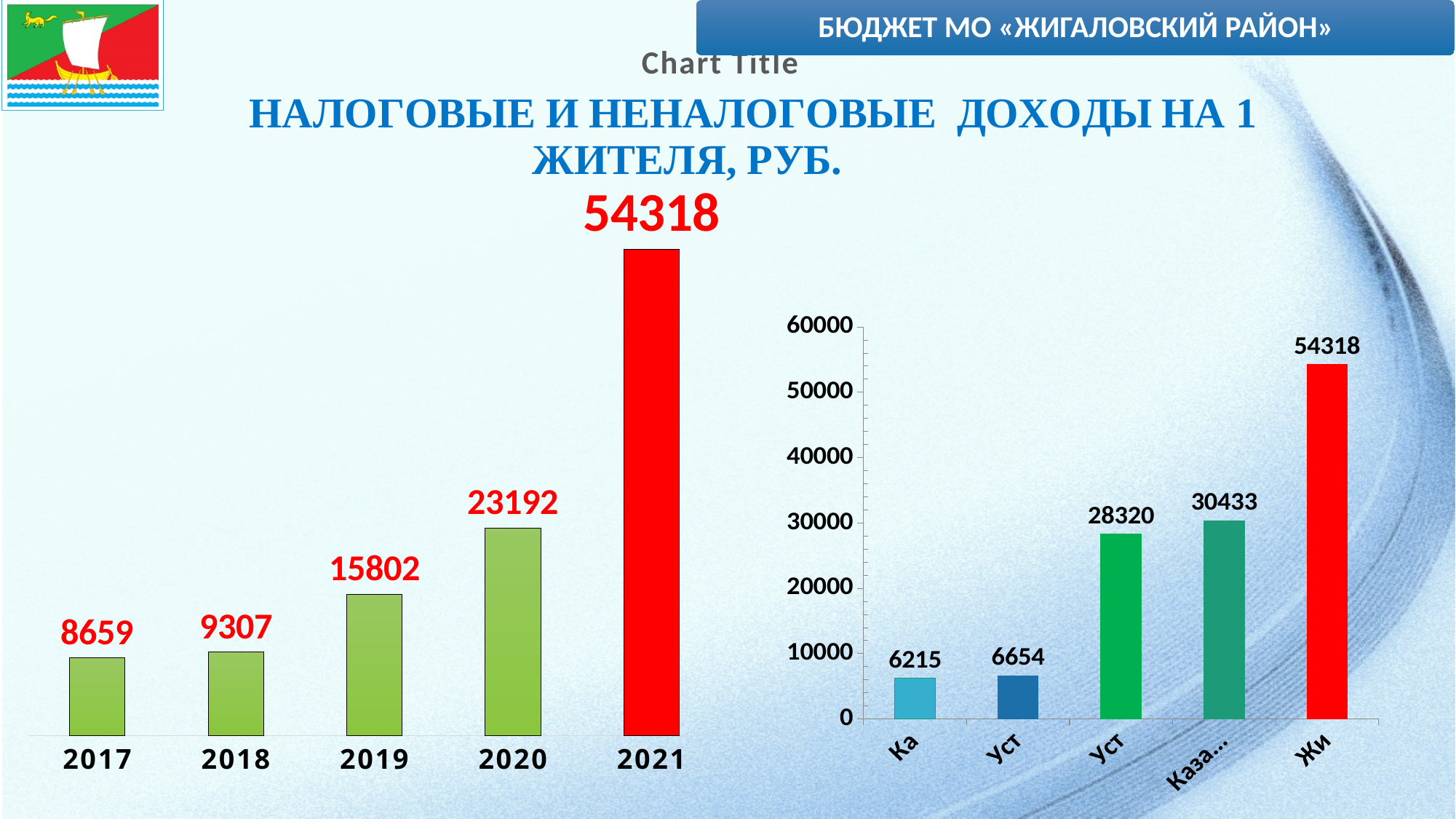
On the right chart, what is the value of the leftmost bar? 6215 On the left chart (years 2017–2021), is the value for 2018 larger or smaller than the value for 2017? larger What type of chart is the right chart? bar chart On the right chart, what is the value of the rightmost (red) bar? 54318 On the left chart (years 2017–2021), do the values rise or fall from 2017 to 2021? rise On the left chart (years 2017–2021), what is the value for 2021? 54318 On the left chart (years 2017–2021), which year has the lowest value? 2017 On the right chart, is the value of the fourth bar from the left greater or less than 30000? greater On the left chart (years 2017–2021), what is the difference between the values for 2020 and 2019? 7390 On the left chart (years 2017–2021), what is the value for 2019? 15802 How many years are shown on the left chart? 5 On the left chart (years 2017–2021), which year has the highest value? 2021